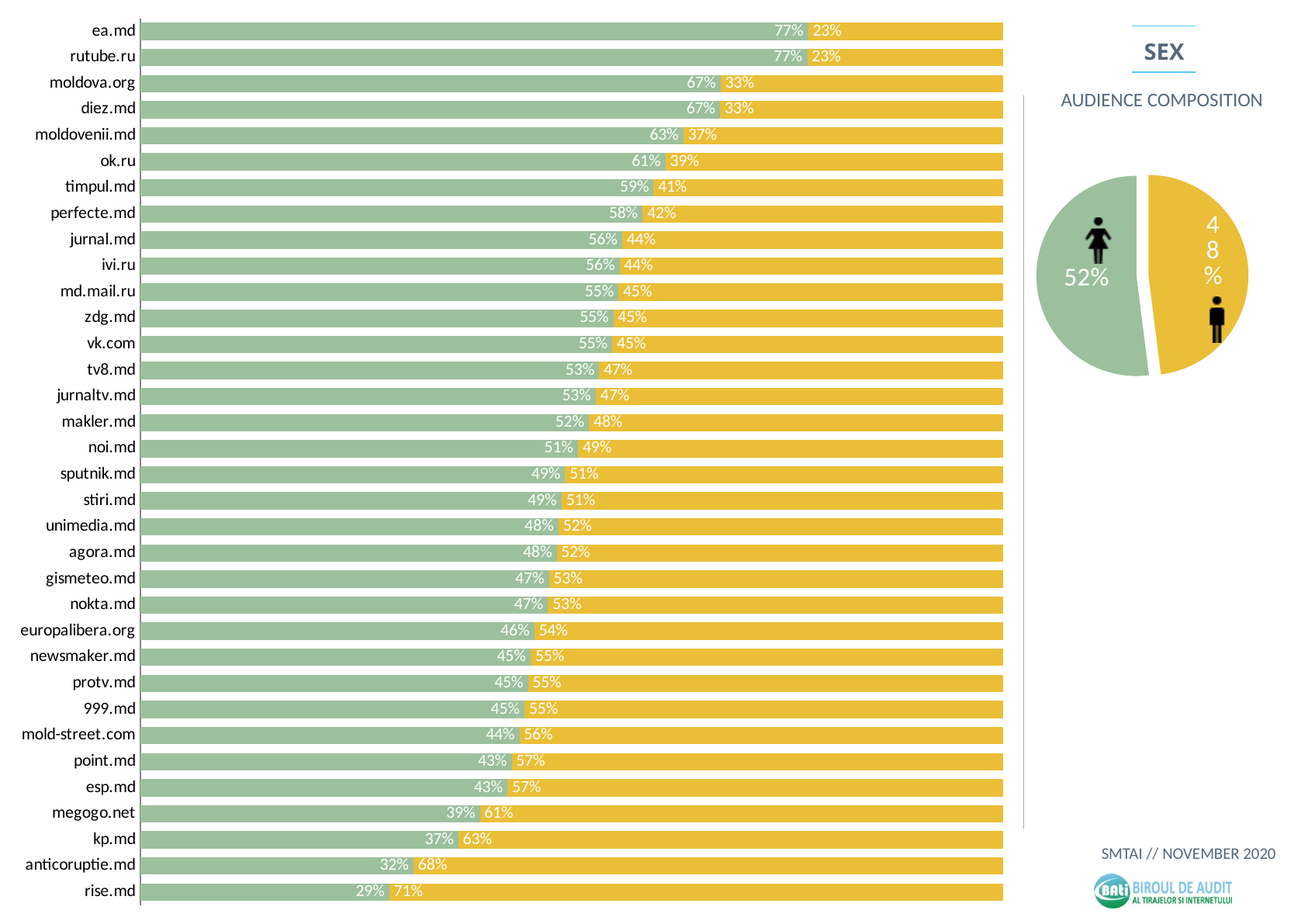
What kind of chart is the large chart on the left of the slide? Stacked bar chart In the bar chart, which site has the largest yellow segment? rise.md In the bar chart, what is the value of the yellow segment for rise.md? 71% In the bar chart, what is the value of the green segment for ea.md? 77% In the pie chart on the right, what share does the green slice (female) represent? 52% What is the title shown above the pie chart on the right? SEX In the bar chart, what is the total of the green and yellow segments for moldova.org? 100% In the bar chart, what is the value of the yellow segment for kp.md? 63% How many sites are listed in the bar chart? 34 In the bar chart, which site has a larger green segment, ok.ru or timpul.md? ok.ru In the bar chart, which site has the smallest green segment? rise.md In the bar chart, what is the difference between the green and yellow segments for ea.md? 54 percentage points